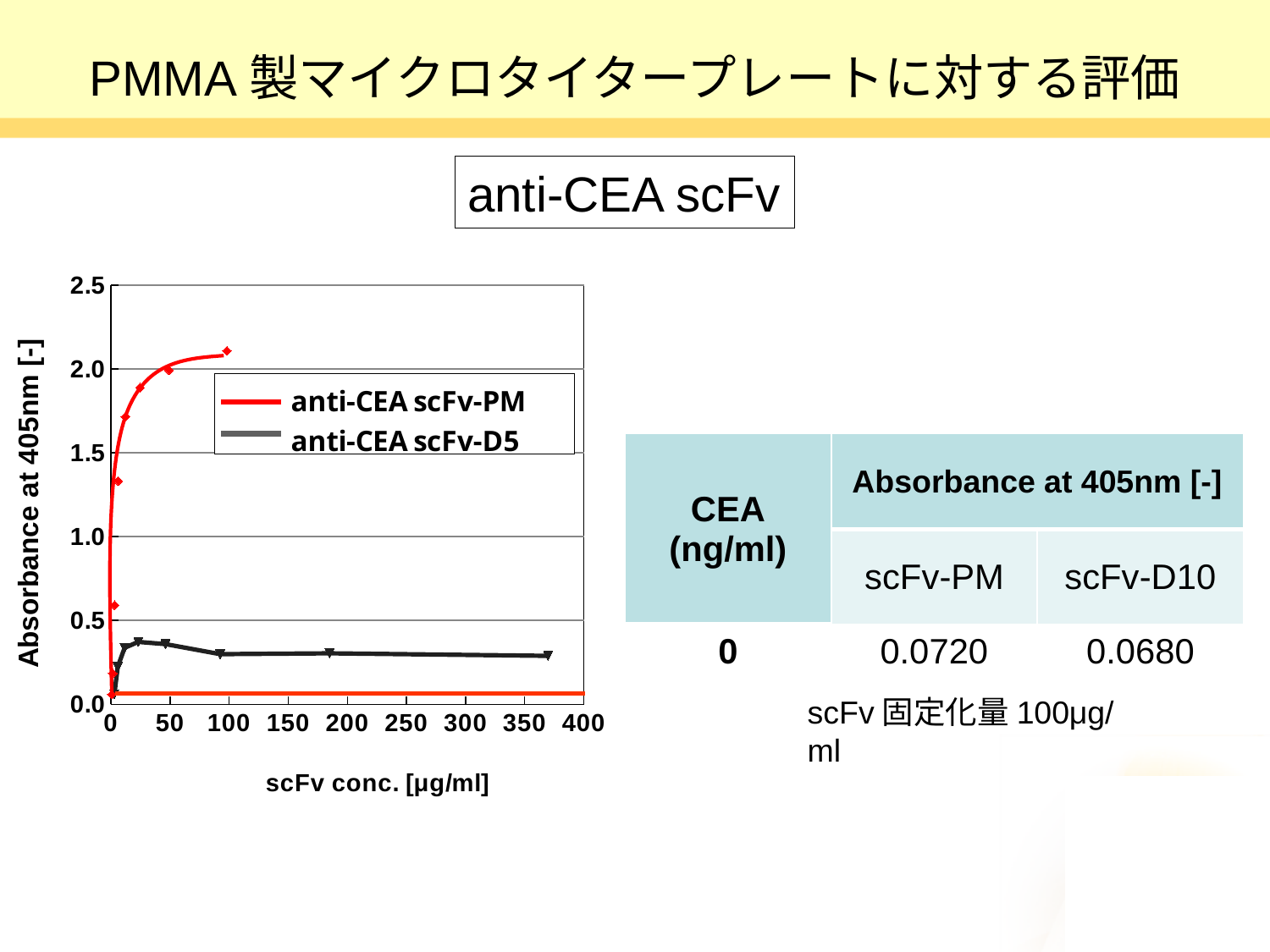
Is the absorbance of anti-CEA scFv-PM at 100 µg/ml greater or less than 1.5? greater Does the absorbance of anti-CEA scFv-PM rise or fall as scFv concentration increases from 0 to 100 µg/ml? rise What is the maximum value shown on the chart's x axis? 400 Is the absorbance of anti-CEA scFv-D5 at 50 µg/ml greater or less than 1.0? less What kind of chart is shown on the slide? line chart How many series does the chart legend list? 2 Which series has the higher absorbance at an scFv concentration of 100 µg/ml, anti-CEA scFv-PM or anti-CEA scFv-D5? anti-CEA scFv-PM Is the absorbance of anti-CEA scFv-D5 at about 370 µg/ml greater or less than 0.5? less What is the label of the chart's y axis? Absorbance at 405nm [-] What are the two series named in the chart legend? anti-CEA scFv-PM and anti-CEA scFv-D5 Which series reaches the highest absorbance on the chart? anti-CEA scFv-PM